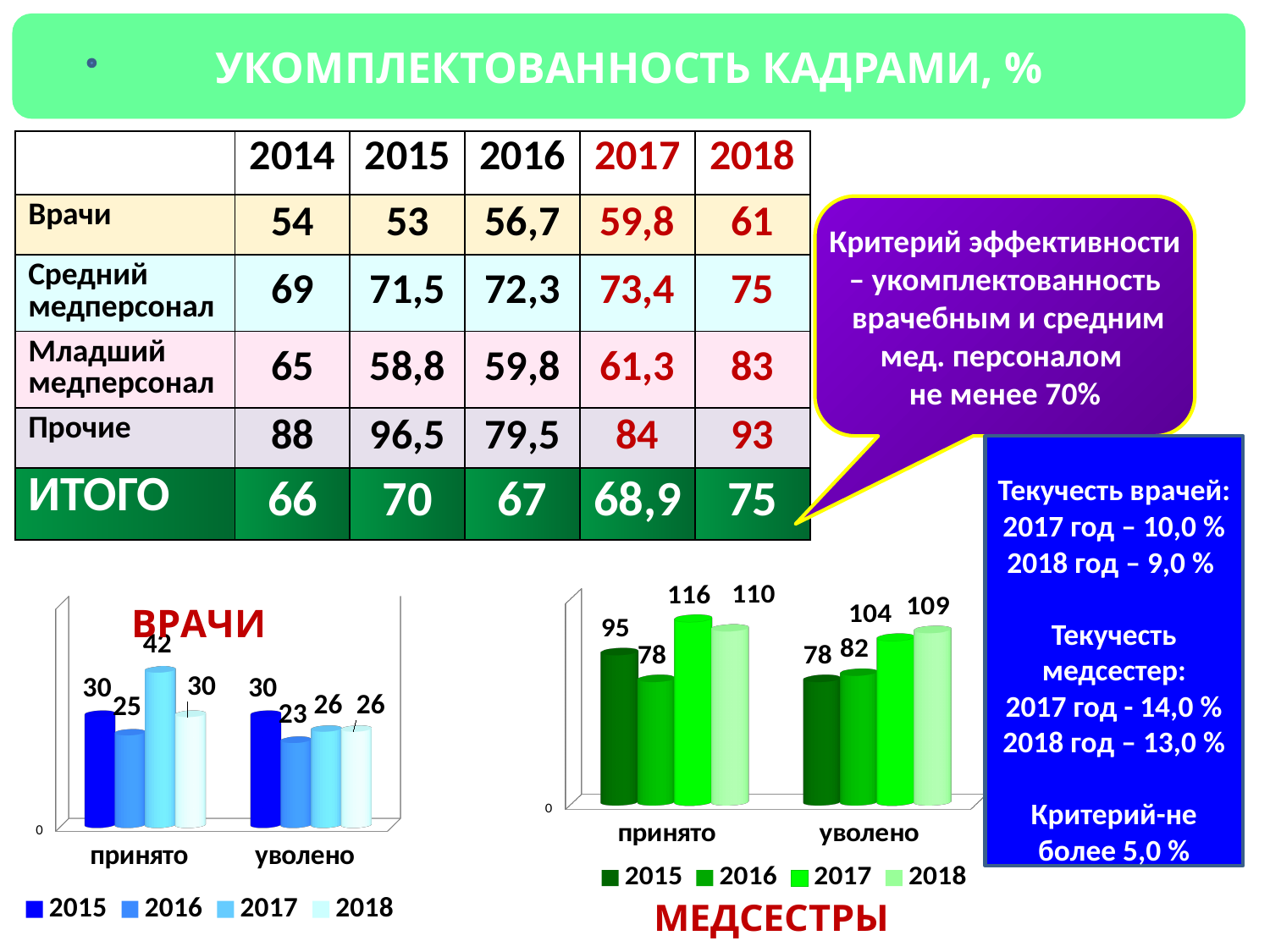
In the МЕДСЕСТРЫ chart, what is the difference between the 2017 and 2015 values in the уволено category? 26 In the МЕДСЕСТРЫ chart, which is larger: the 2015 value for принято or the 2015 value for уволено? принято In the МЕДСЕСТРЫ chart, what is the value for 2017 in the принято category? 116 In the МЕДСЕСТРЫ chart, which year has the lowest value in the принято category? 2016 What kind of chart is the МЕДСЕСТРЫ chart? bar chart In the ВРАЧИ chart, how many series does the legend list? 4 In the ВРАЧИ chart, what is the difference between the 2017 and 2016 values in the принято category? 17 In the МЕДСЕСТРЫ chart, what is the value for 2018 in the уволено category? 109 In the ВРАЧИ chart, which year has the highest value in the принято category? 2017 In the ВРАЧИ chart, what is the value for 2016 in the уволено category? 23 In the ВРАЧИ chart, what is the value for 2017 in the принято category? 42 How many categories are shown on the x axis of the ВРАЧИ chart? 2